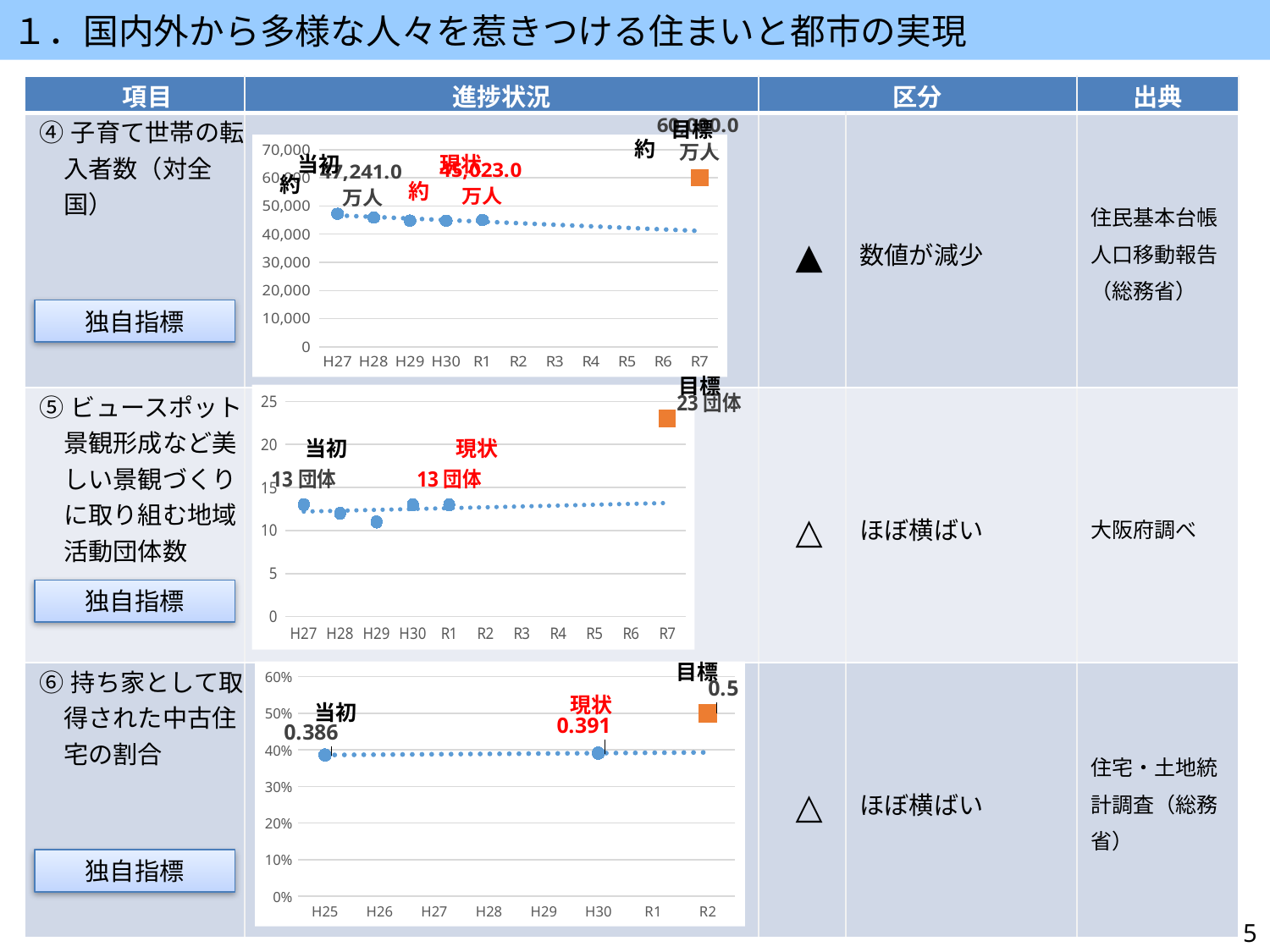
In the chart for ⑥ 持ち家として取得された中古住宅の割合, how many categories are shown on the x axis? 8 In the chart for ⑥ 持ち家として取得された中古住宅の割合, what is the 現状 value? 0.391 In the chart for ④ 子育て世帯の転入者数（対全国）, do the plotted values rise or fall from H27 to R1? fall In the chart for ⑥ 持ち家として取得された中古住宅の割合, what is the 目標 value? 0.5 In the chart for ⑤ ビュースポット景観形成など美しい景観づくりに取り組む地域活動団体数, is the value for H29 greater or less than 15? less In the chart for ④ 子育て世帯の転入者数（対全国）, is the value for H27 greater or less than 40,000? greater In the chart for ⑥ 持ち家として取得された中古住宅の割合, which is larger, the 当初 value or the 現状 value? 現状 In the chart for ⑤ ビュースポット景観形成など美しい景観づくりに取り組む地域活動団体数, how many categories are shown on the x axis? 11 In the chart for ⑥ 持ち家として取得された中古住宅の割合, what is the 当初 value? 0.386 In the chart for ⑥ 持ち家として取得された中古住宅の割合, what is the difference between the 現状 value and the 当初 value? 0.005 In the chart for ⑤ ビュースポット景観形成など美しい景観づくりに取り組む地域活動団体数, what is the 当初 value? 13団体 In the chart for ⑤ ビュースポット景観形成など美しい景観づくりに取り組む地域活動団体数, what is the 目標 value? 23団体